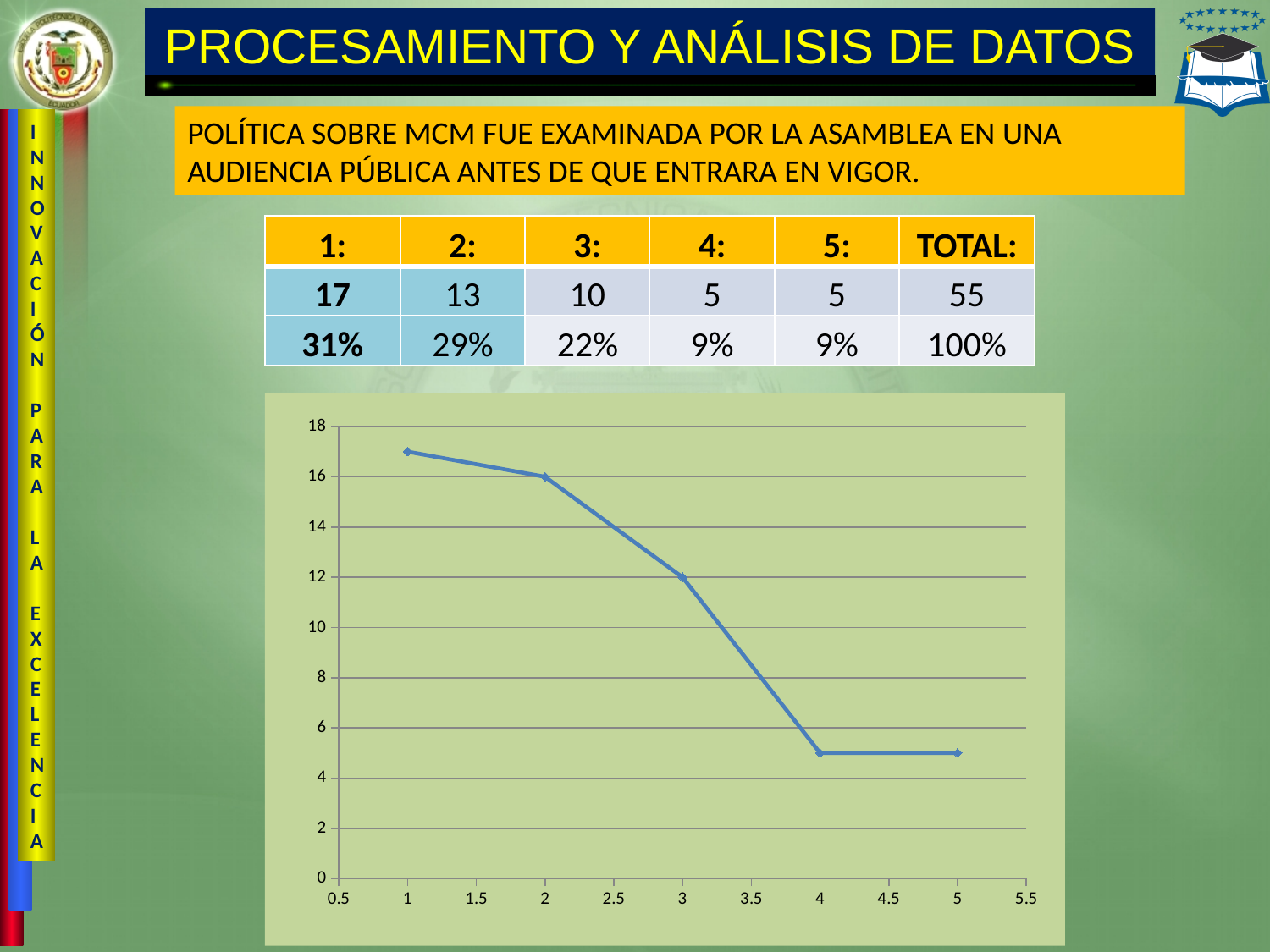
Is the value at x = 3 greater or less than 10? greater At which x value is the plotted value highest? 1 Which has the larger plotted value, x = 1 or x = 4? 1 Is the value at x = 5 greater or less than 8? less Is the value at x = 1 greater or less than 16? greater What is the highest tick value shown on the y axis of the chart? 18 What kind of chart is shown on the slide? line chart How many data points are plotted on the line chart? 5 Which has the larger plotted value, x = 2 or x = 3? 2 Do the plotted values rise or fall as x increases from 1 to 5? fall